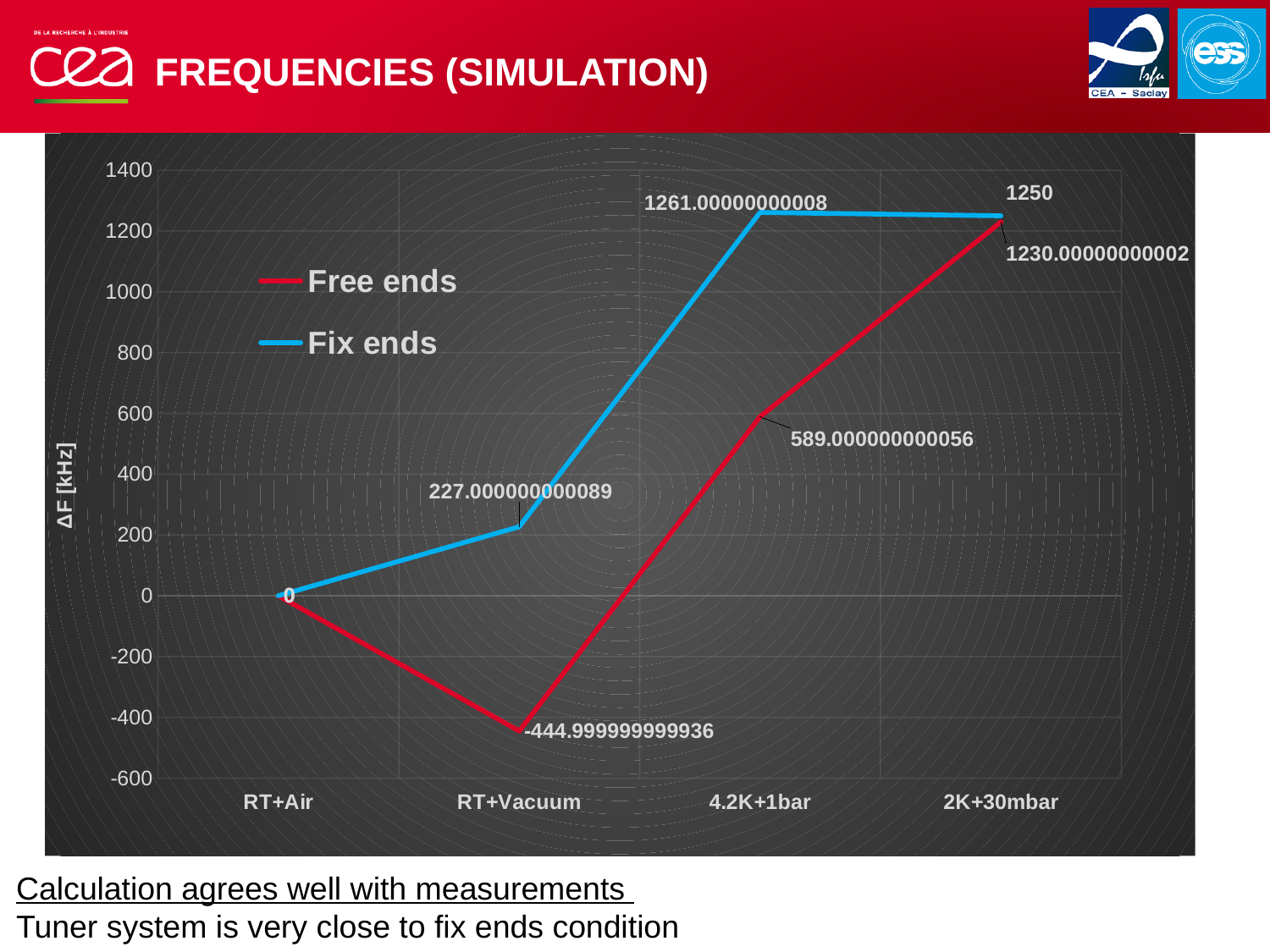
At which category does the Fix ends series reach its highest value? 4.2K+1bar What is the value of the Free ends series at RT+Vacuum? -444.999999999936 How many categories are shown on the x axis? 4 What type of chart is shown on the slide? Line chart How many series does the legend list? 2 Is the value of the Free ends series at 4.2K+1bar greater or less than 400? greater What is the value of the Fix ends series at 4.2K+1bar? 1261.00000000008 What is the value of the Free ends series at 4.2K+1bar? 589.000000000056 What is the value of the Fix ends series at 2K+30mbar? 1250 At which category does the Free ends series reach its lowest value? RT+Vacuum At 4.2K+1bar, which series has the larger value, Free ends or Fix ends? Fix ends What is the value of the Fix ends series at RT+Vacuum? 227.000000000089